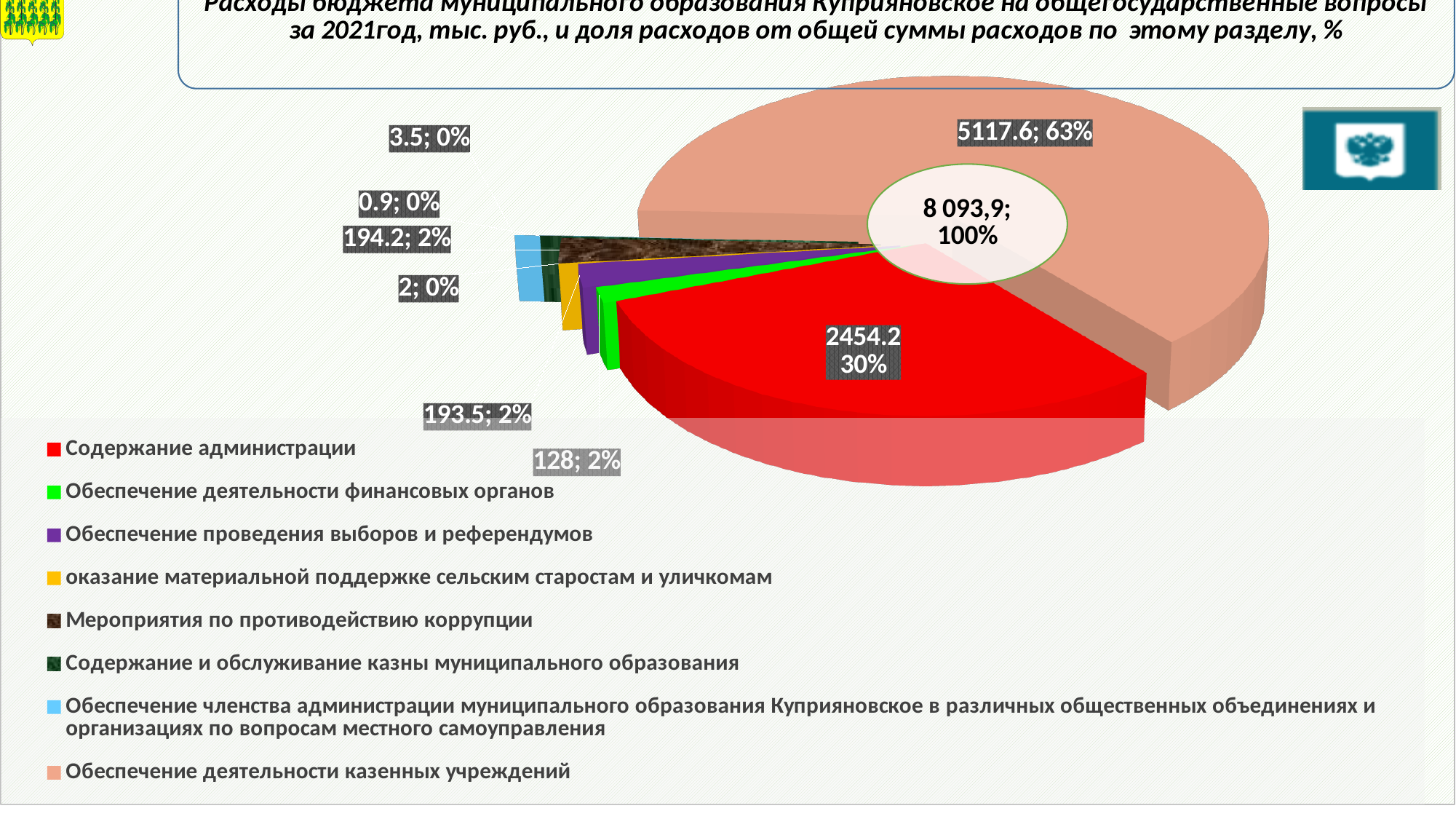
What colour is the slice for Содержание администрации in the pie chart? red Which category has the largest slice of the pie chart? Обеспечение деятельности казенных учреждений What is the difference between the value for Обеспечение деятельности казенных учреждений (5117.6) and the value for Содержание администрации (2454.2)? 2663.4 Which is larger: the slice for Содержание администрации or the slice for Обеспечение деятельности казенных учреждений? Обеспечение деятельности казенных учреждений What value is shown for the largest slice (Обеспечение деятельности казенных учреждений)? 5117.6 What kind of chart is shown on the slide? pie chart What is the smallest value printed as a data label on the pie chart? 0.9 What share of the pie does the slice for Обеспечение деятельности казенных учреждений represent? 63% What share of the pie does the slice for Содержание администрации represent? 30% How many categories does the legend of the pie chart list? 8 What value is shown for the red slice, Содержание администрации? 2454.2 What total is shown in the centre of the pie chart? 8 093,9